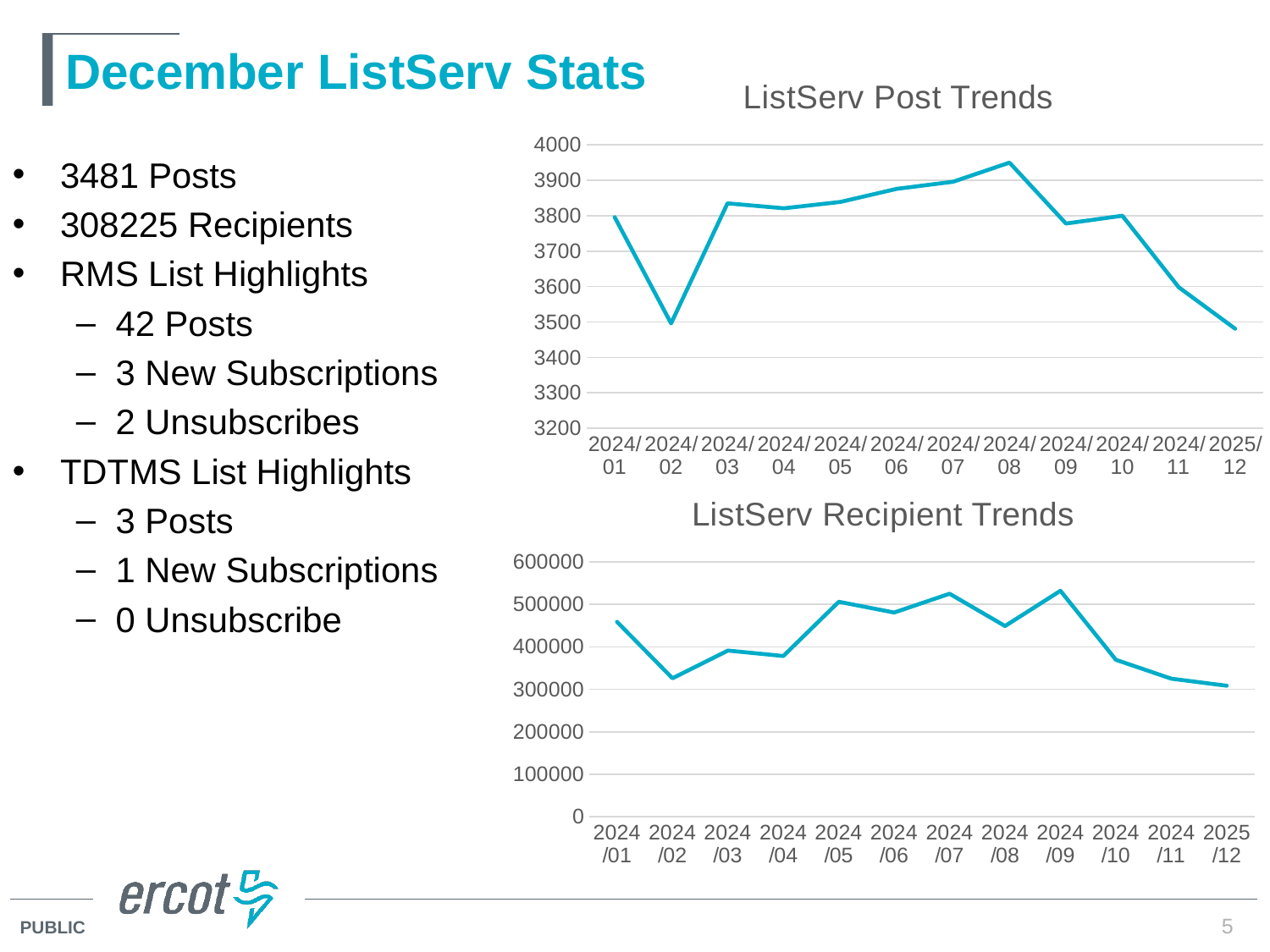
In the ListServ Post Trends chart, which is larger, the value for 2024/03 or the value for 2024/02? 2024/03 How many data points are plotted in the ListServ Post Trends chart? 12 In the ListServ Recipient Trends chart, is the value for 2025/12 greater or less than 400000? less In the ListServ Recipient Trends chart, which is larger, the value for 2024/05 or the value for 2024/04? 2024/05 In the ListServ Post Trends chart, is the value for 2024/02 greater or less than 3600? less In the ListServ Post Trends chart, is the value for 2024/08 greater or less than 3900? greater What is the title of the lower chart on the slide? ListServ Recipient Trends What kind of chart is the ListServ Post Trends chart? Line chart In the ListServ Recipient Trends chart, do the values rise or fall from 2024/09 to 2025/12? Fall In the ListServ Post Trends chart, which month has the highest number of posts? 2024/08 In the ListServ Post Trends chart, do the values rise or fall from 2024/08 to 2025/12? Fall